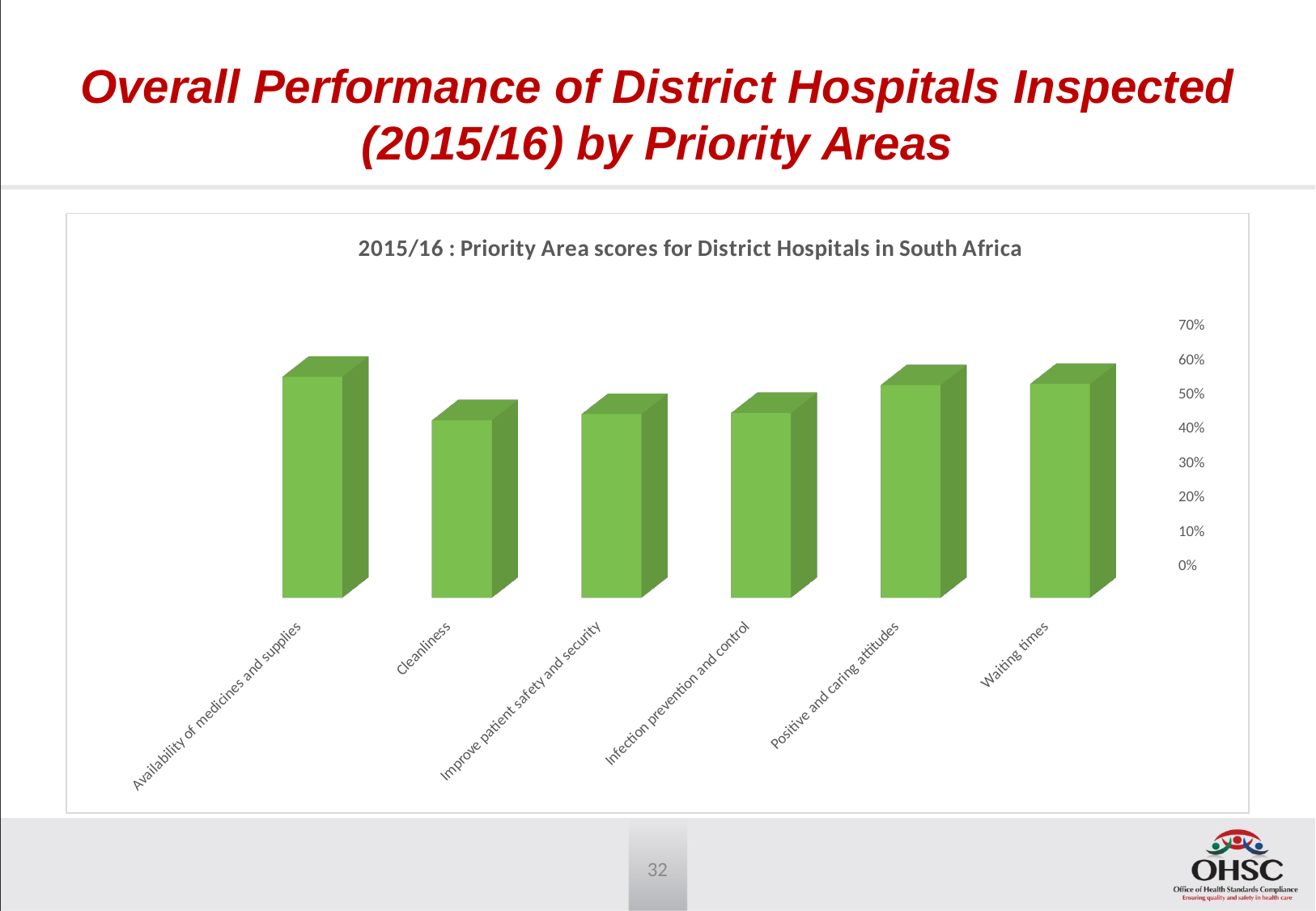
Is the score for Cleanliness greater or less than 60%? less Which priority area has the highest score? Availability of medicines and supplies Which has a higher score, Positive and caring attitudes or Cleanliness? Positive and caring attitudes Is the score for Waiting times greater or less than 30%? greater How many priority areas are plotted in the chart? 6 What kind of chart is shown on the slide? Bar chart What is the highest value shown on the percentage axis? 70% What is the title of the chart? 2015/16 : Priority Area scores for District Hospitals in South Africa Is the score for Availability of medicines and supplies greater or less than 50%? greater Which has a higher score, Availability of medicines and supplies or Cleanliness? Availability of medicines and supplies